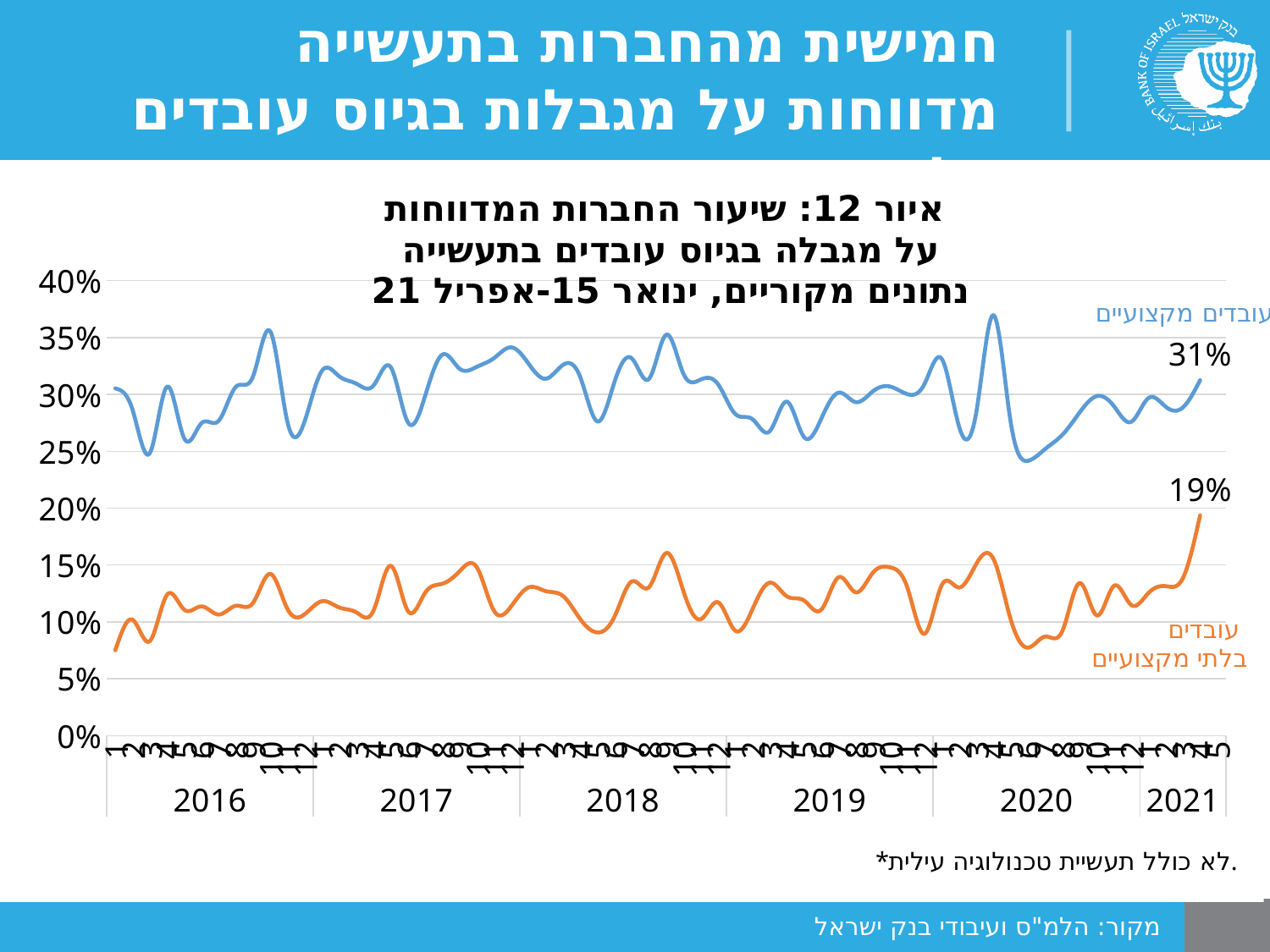
How many year labels appear on the x axis? 6 Does the non-professional workers series rise or fall over the final months shown in 2021? rise How many series are plotted in the chart? 2 What colour is the line for the non-professional workers (עובדים בלתי מקצועיים) series? orange Is the lowest point of the professional workers series greater or less than 20%? greater What is the latest labelled value for the professional workers (עובדים מקצועיים) series? 31% What kind of chart is shown on the slide? line chart Is the highest point of the professional workers series, reached in 2020, greater or less than 35%? greater What is the latest labelled value for the non-professional workers (עובדים בלתי מקצועיים) series? 19% Is the value of the non-professional workers series at the start of 2016 greater or less than 10%? less Which series has the higher latest labelled value, professional workers or non-professional workers? professional workers (עובדים מקצועיים) What is the difference between the latest labelled values of the professional workers series (31%) and the non-professional workers series (19%)? 12 percentage points